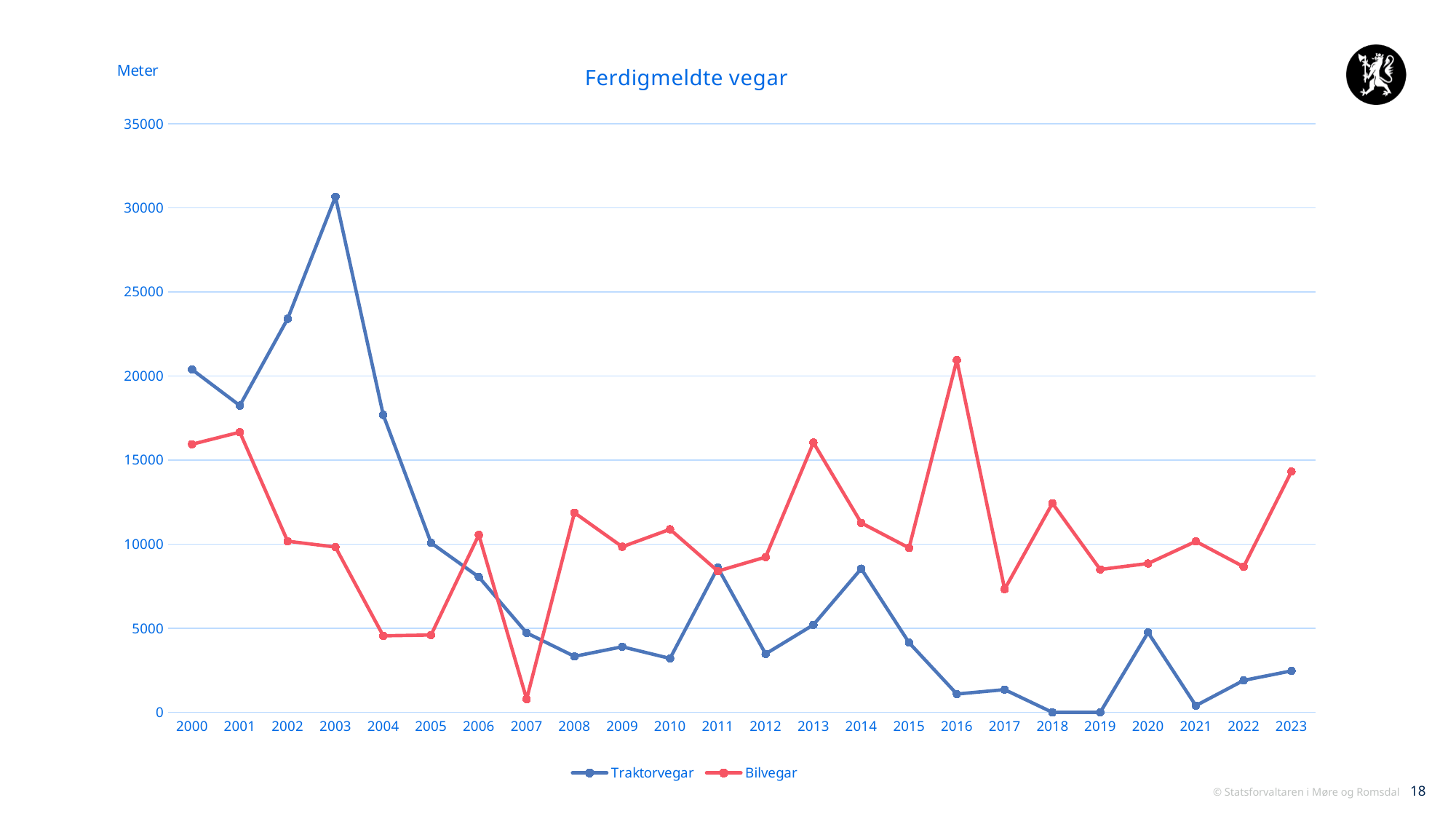
In which year does the Traktorvegar series reach its highest value? 2003 What kind of chart is shown on the slide? line chart In which year does the Bilvegar series reach its highest value? 2016 Does the Traktorvegar series rise or fall between 2003 and 2007? fall Which series has the larger value in 2016, Traktorvegar or Bilvegar? Bilvegar How many years are plotted along the x axis? 24 Is the value for Traktorvegar in 2003 greater or less than 25000? greater In which year does the Bilvegar series reach its lowest value? 2007 Is the value for Traktorvegar in 2012 greater or less than 5000? less Is the value for Bilvegar in 2016 greater or less than 20000? greater What is the title of the chart? Ferdigmeldte vegar How many series does the legend list? 2